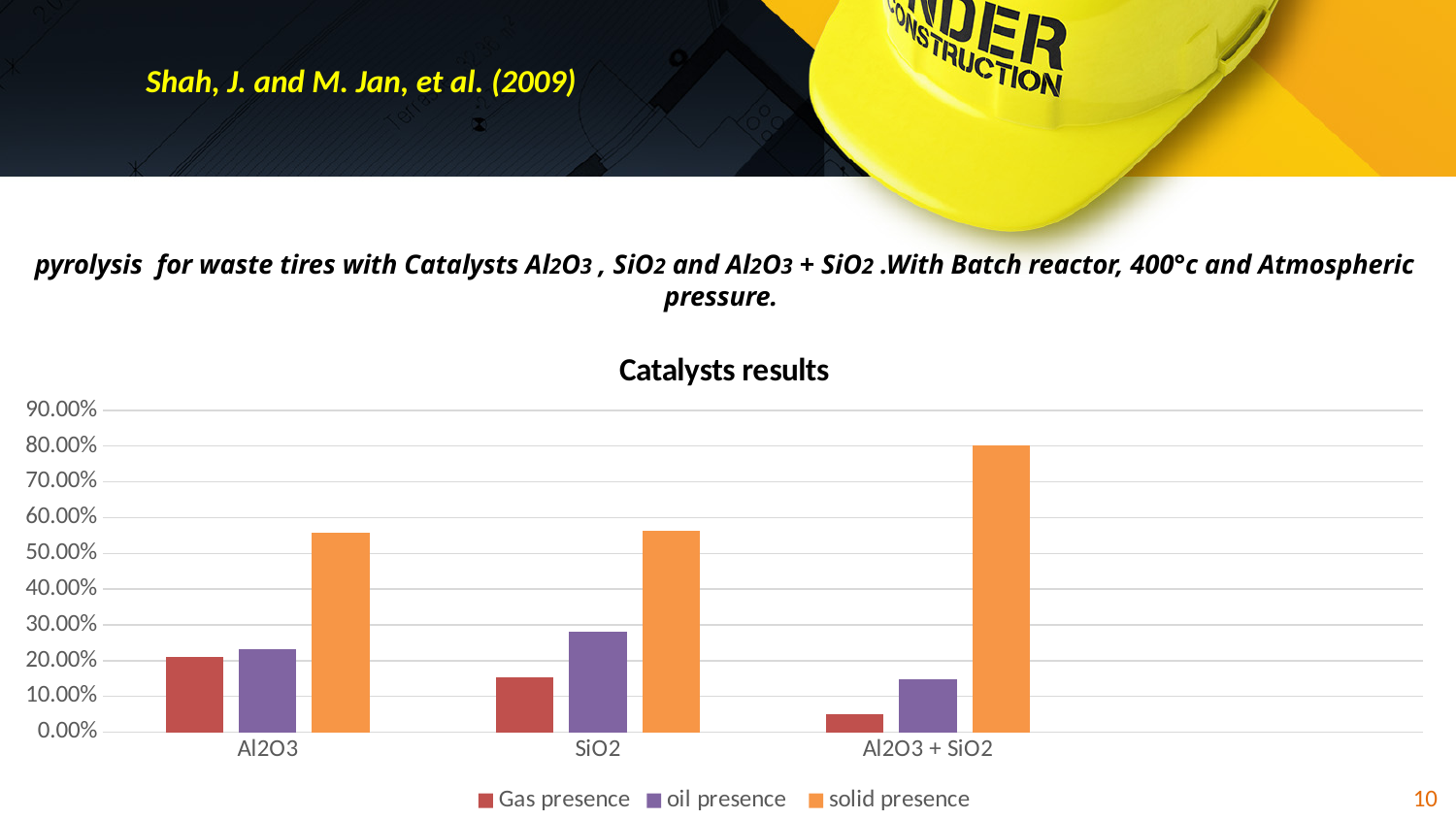
Which catalyst has the highest solid presence? Al2O3 + SiO2 Which is larger: the gas presence for Al2O3 or the gas presence for SiO2? Al2O3 Which catalyst has the lowest gas presence? Al2O3 + SiO2 Is the solid presence for Al2O3 greater or less than 50.00%? greater Is the gas presence for Al2O3 + SiO2 greater or less than 10.00%? less How many series does the legend list? 3 Is the solid presence for Al2O3 + SiO2 greater or less than 70.00%? greater What type of chart is shown on the slide? Bar chart What is the title of the chart? Catalysts results Which series is shown in orange in the legend? solid presence How many catalyst categories are shown on the x axis? 3